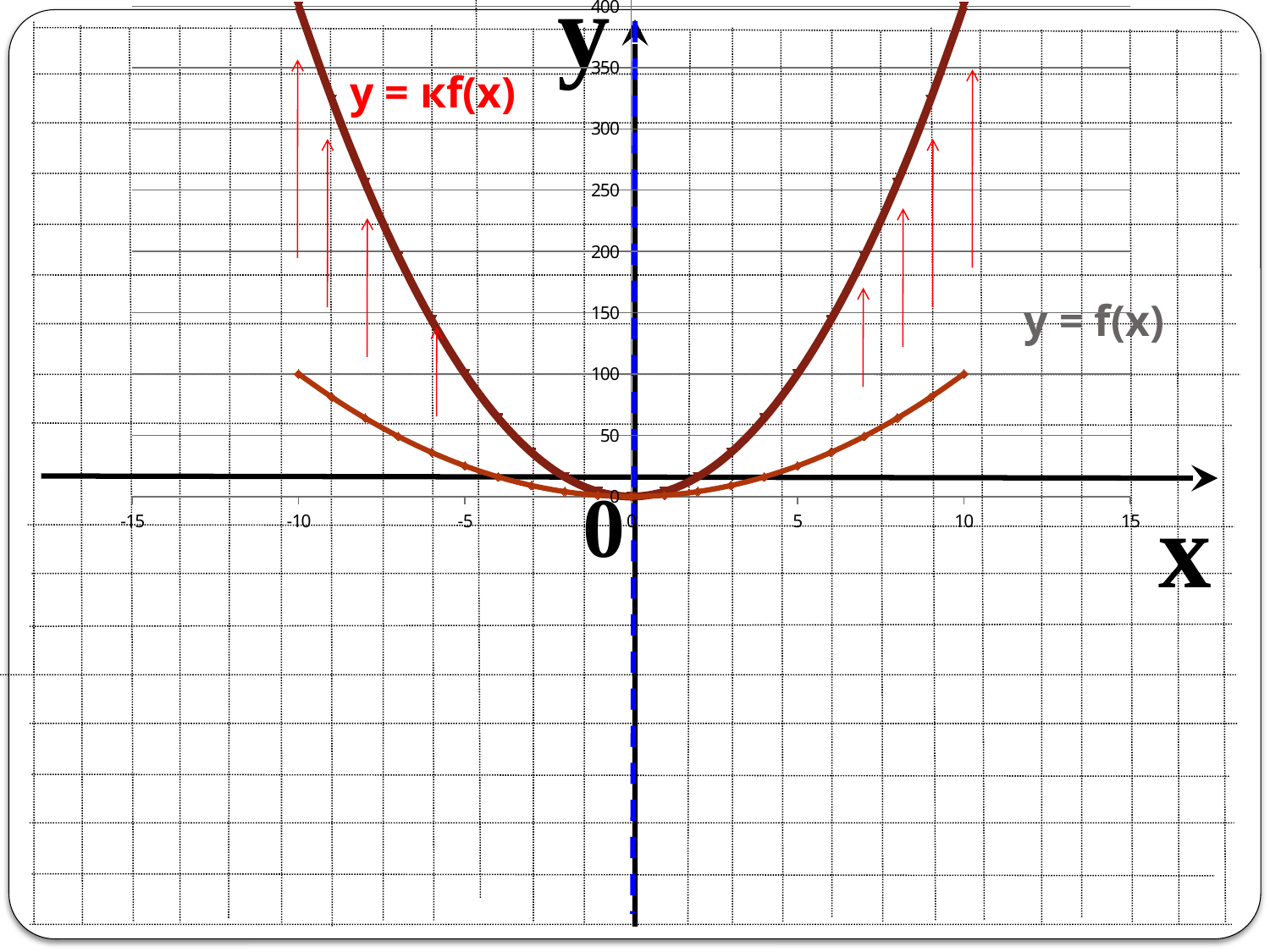
What is the value of y = κf(x) at x = 10? 400 At x = 8, which curve has the higher value, y = f(x) or y = κf(x)? y = κf(x) How many curves are plotted on the chart? 2 What is the value of y = κf(x) at x = 5? 100 Is the value of y = f(x) at x = 5 greater or less than 50? less What is the highest value labelled on the y axis? 400 What is the value of y = f(x) at x = 10? 100 At what x value do both curves reach their minimum? 0 What is the value of y = f(x) at x = -10? 100 What kind of chart is shown on the slide? line chart For x greater than 0, does y = f(x) rise or fall as x increases? rise At x = 10, what is the difference between y = κf(x) and y = f(x)? 300